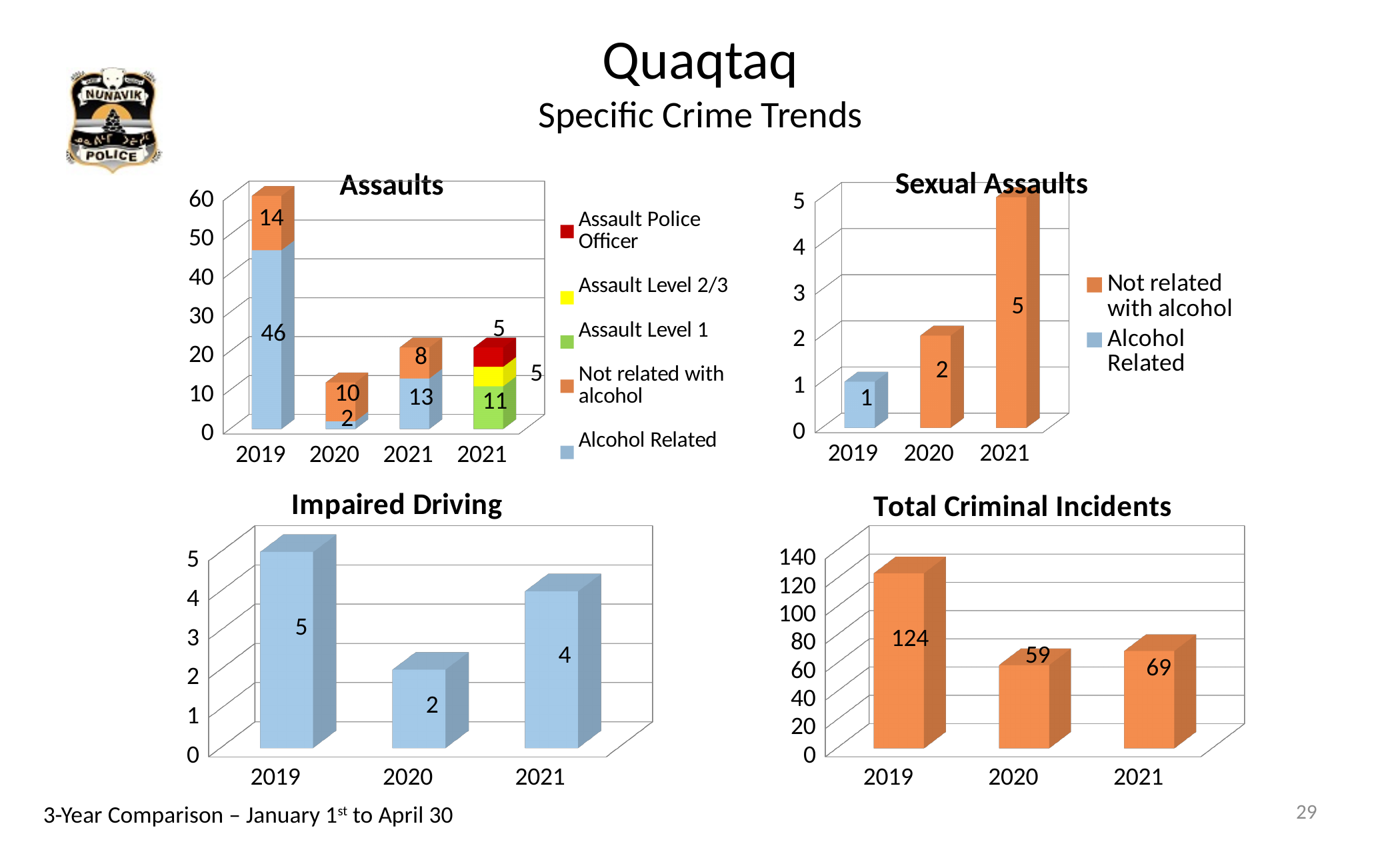
In the Total Criminal Incidents chart, what is the value for 2019? 124 In the Sexual Assaults chart, do the values rise or fall from 2019 to 2021? rise In the Impaired Driving chart, what is the value for 2021? 4 In the Impaired Driving chart, how many years are shown on the x axis? 3 In the Sexual Assaults chart, what is the value for 2021? 5 In the Sexual Assaults chart, how many series does the legend list? 2 In the Total Criminal Incidents chart, what is the difference between the 2019 and 2021 values? 55 In the Total Criminal Incidents chart, which year has the lowest value? 2020 In the Assaults chart, how many series does the legend list? 5 In the Impaired Driving chart, which year has the highest value? 2019 In the Assaults chart, what is the Alcohol Related value for 2019? 46 In the Assaults chart, what is the total of the stacked bar for 2019? 60